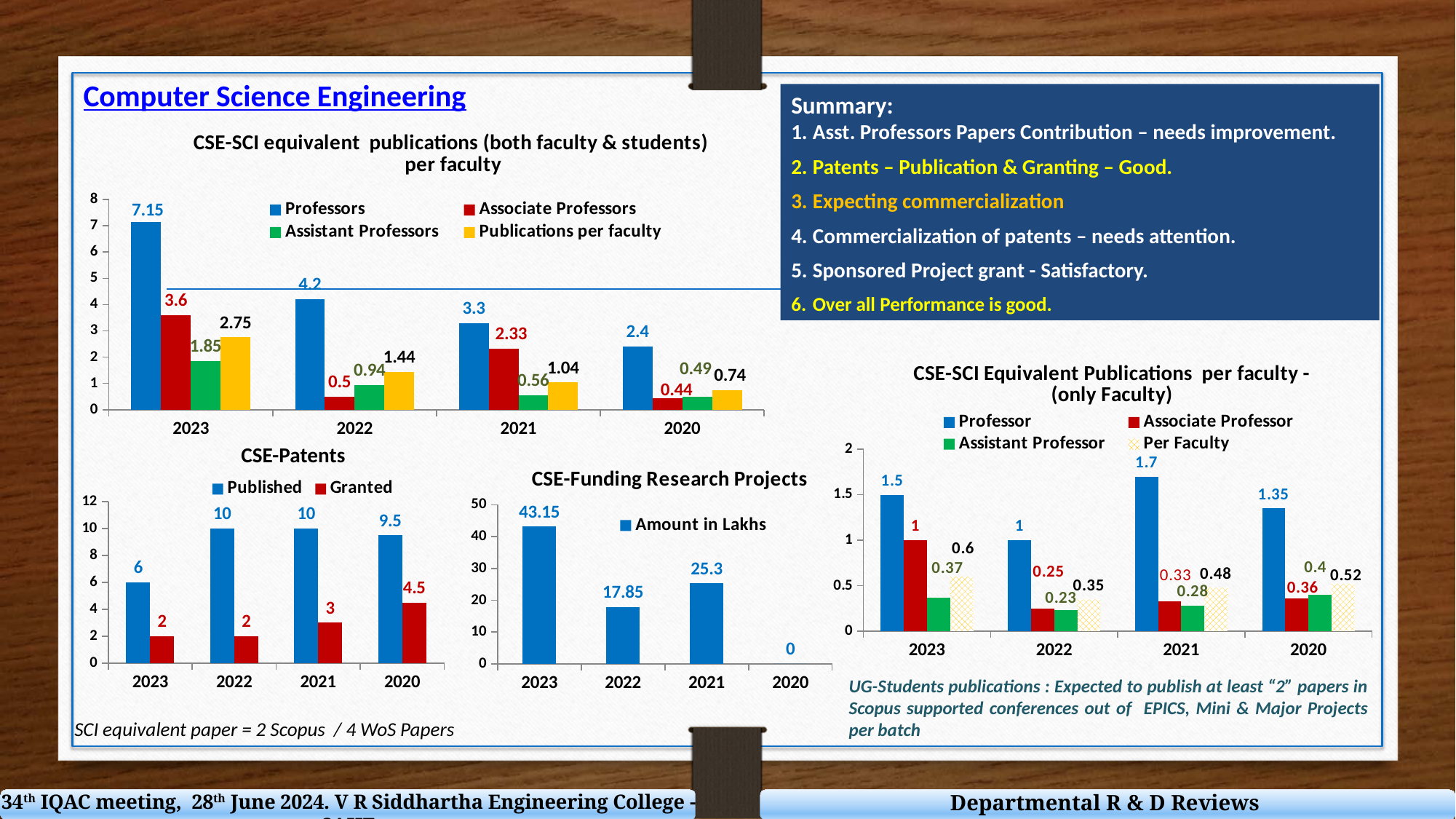
What kind of chart is 'CSE-Funding Research Projects'? bar chart In the 'CSE-SCI equivalent publications (both faculty & students) per faculty' chart, which year has the highest value for Publications per faculty? 2023 In the 'CSE-Patents' chart, what is the Granted value for 2020? 4.5 In the 'CSE-SCI equivalent publications (both faculty & students) per faculty' chart, what is the value for Professors in 2023? 7.15 In the 'CSE-SCI equivalent publications (both faculty & students) per faculty' chart, how many series does the legend list? 4 In the 'CSE-Funding Research Projects' chart, which year has the highest Amount in Lakhs? 2023 In the 'CSE-SCI Equivalent Publications per faculty - (only Faculty)' chart, which is larger in 2020: Associate Professor or Assistant Professor? Assistant Professor In the 'CSE-SCI equivalent publications (both faculty & students) per faculty' chart, what is the difference between the Associate Professors values for 2023 and 2021? 1.27 In the 'CSE-SCI Equivalent Publications per faculty - (only Faculty)' chart, what is the Professor value for 2021? 1.7 In the 'CSE-Funding Research Projects' chart, what is the Amount in Lakhs for 2021? 25.3 In the 'CSE-Patents' chart, what is the difference between Published and Granted in 2021? 7 In the 'CSE-Patents' chart, which year has the lowest Published value? 2023